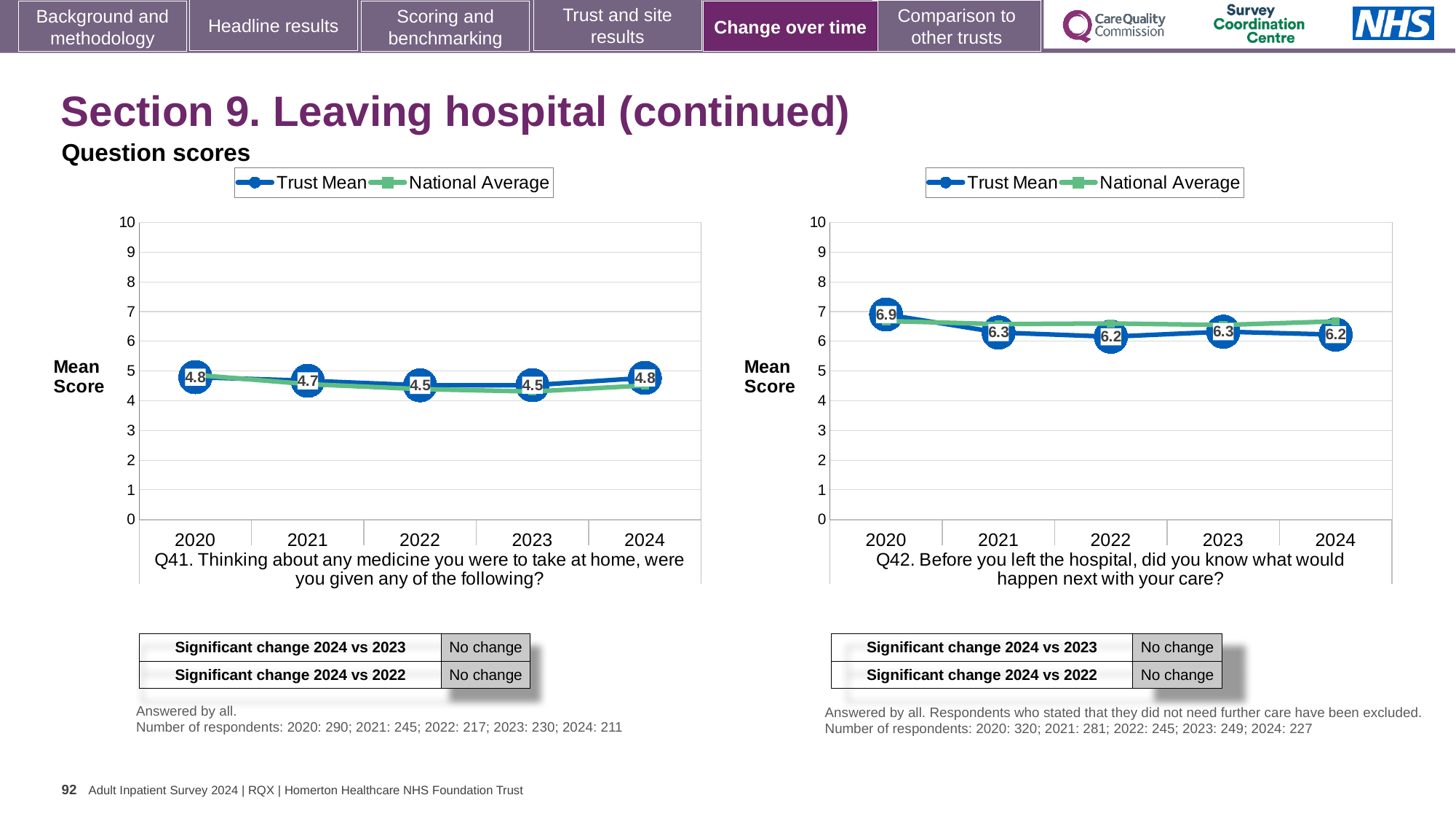
In the Q41 chart, what is the difference between the Trust Mean score in 2024 and in 2023? 0.3 In the Q42 chart, is the Trust Mean score for 2021 greater or less than 7? less How many years are plotted on the x axis of the Q41 chart? 5 In the Q41 chart, what is the Trust Mean score for 2020? 4.8 In the Q42 chart, what is the Trust Mean score for 2020? 6.9 In the Q42 chart, what is the Trust Mean score for 2024? 6.2 In the Q42 chart, what is the difference between the Trust Mean score in 2020 and in 2021? 0.6 What kind of chart is the Q41 chart? Line chart In the Q41 chart, is the Trust Mean score for 2021 greater or less than 5? less In the Q42 chart, which year has the highest Trust Mean score? 2020 How many series does the legend of the Q42 chart list? 2 In the Q41 chart, what is the Trust Mean score for 2022? 4.5